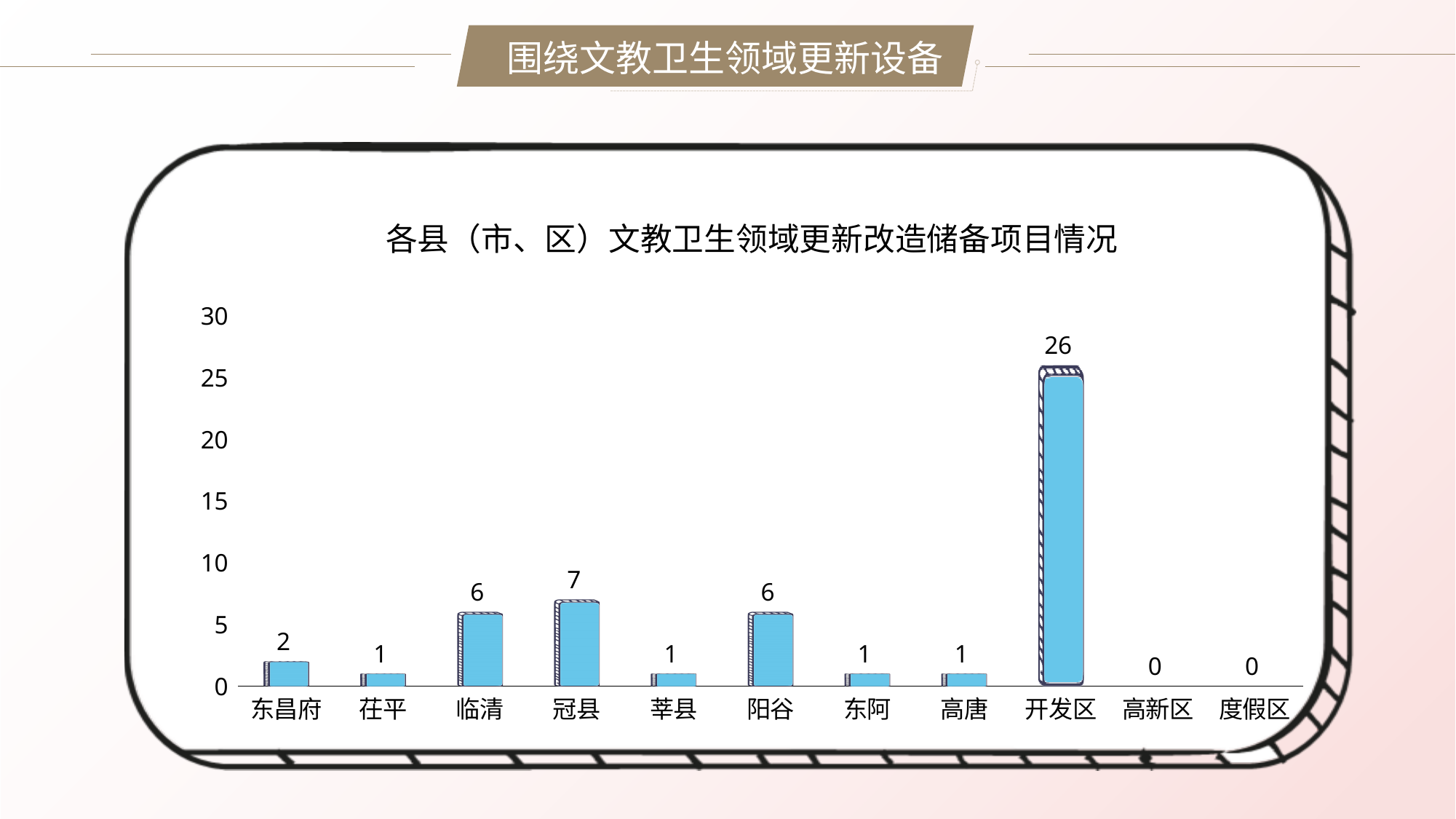
What is the value for 开发区? 26 Is the value for 开发区 greater or less than 20? greater Which is larger, the value for 冠县 or the value for 临清? 冠县 Which category has the highest value? 开发区 What is the value for 冠县? 7 What is the title of the chart? 各县（市、区）文教卫生领域更新改造储备项目情况 What kind of chart is shown on the slide? bar chart What is the value for 东昌府? 2 What is the difference between the values for 开发区 and 冠县? 19 What is the value for 阳谷? 6 How many categories are shown on the x axis? 11 What is the difference between the values for 临清 and 东昌府? 4